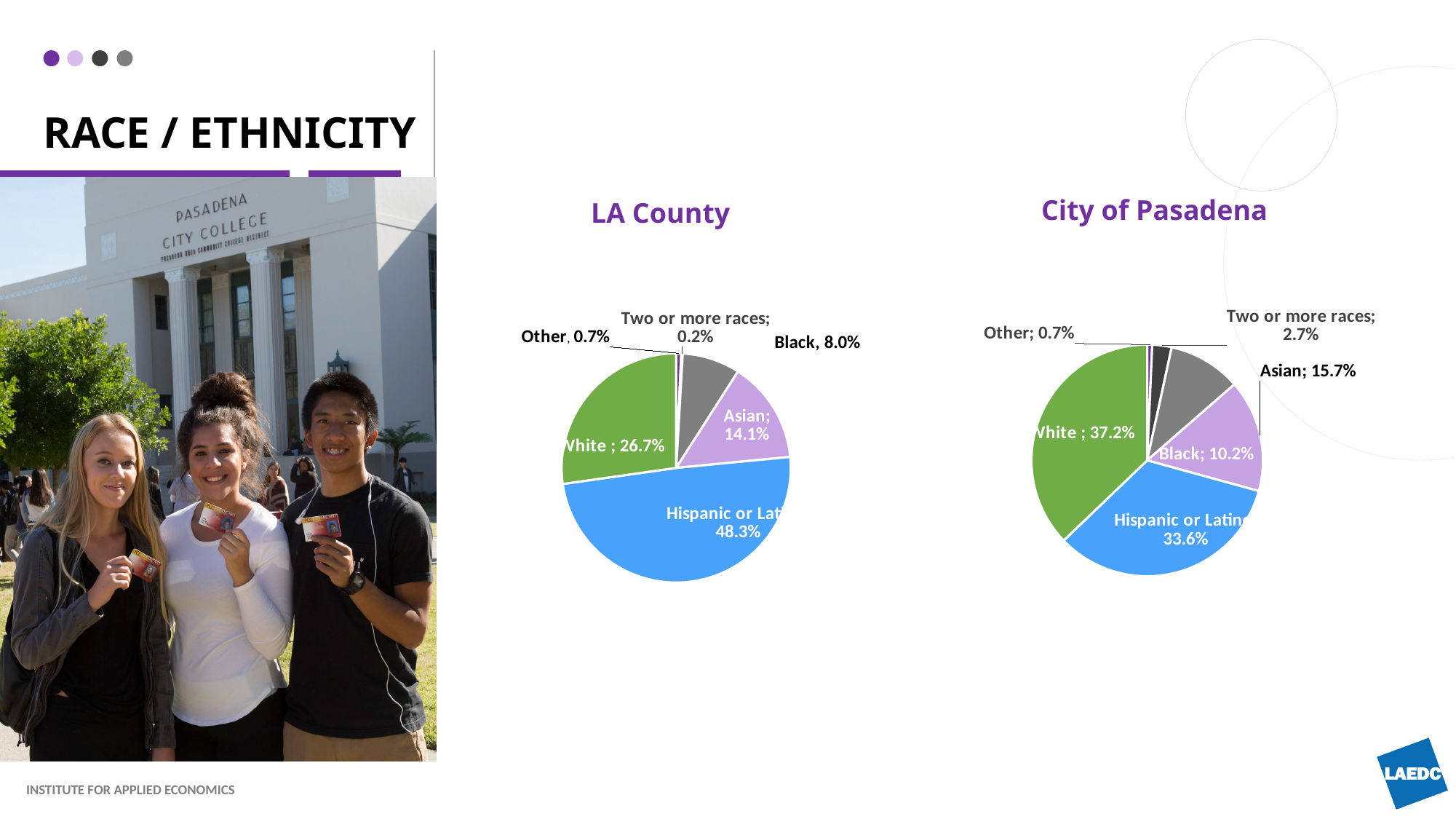
What type of chart is used for the City of Pasadena data? Pie chart In the City of Pasadena chart, what share is Black? 10.2% In the LA County chart, which category has the largest share? Hispanic or Latino In the LA County chart, what share is Asian? 14.1% In the City of Pasadena chart, which category has the largest share? White What is the difference between the White share in the City of Pasadena chart and the White share in the LA County chart? 10.5% In the LA County chart, what share is Hispanic or Latino? 48.3% In the LA County chart, which category has the smallest share? Two or more races In the City of Pasadena chart, what share is White? 37.2% In the City of Pasadena chart, what share is Two or more races? 2.7% How many categories does the LA County pie chart show? 6 In the City of Pasadena chart, which is larger, the Asian share or the Black share? Asian